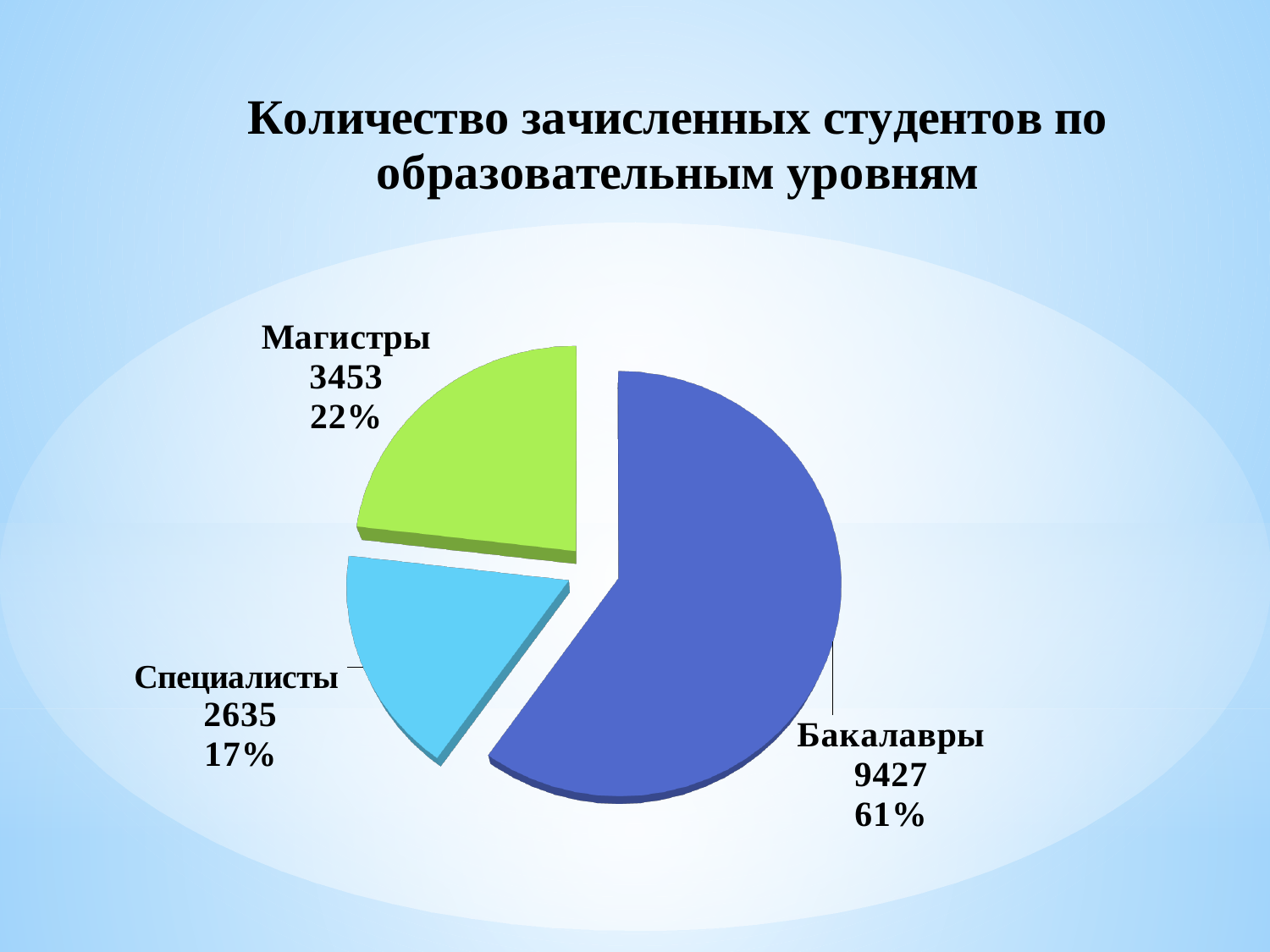
What kind of chart is shown on the slide? pie chart Which category has the smallest slice? Специалисты What is the difference between the values for Магистры and Специалисты? 818 What share of the pie does Специалисты represent? 17% Which category has the largest slice? Бакалавры What is the number of enrolled students for Бакалавры? 9427 What is the number of enrolled students for Специалисты? 2635 What is the title of the chart? Количество зачисленных студентов по образовательным уровням Which is larger, the value for Магистры or the value for Специалисты? Магистры How many slices does the pie chart have? 3 What share of the pie does Бакалавры represent? 61% What is the number of enrolled students for Магистры? 3453